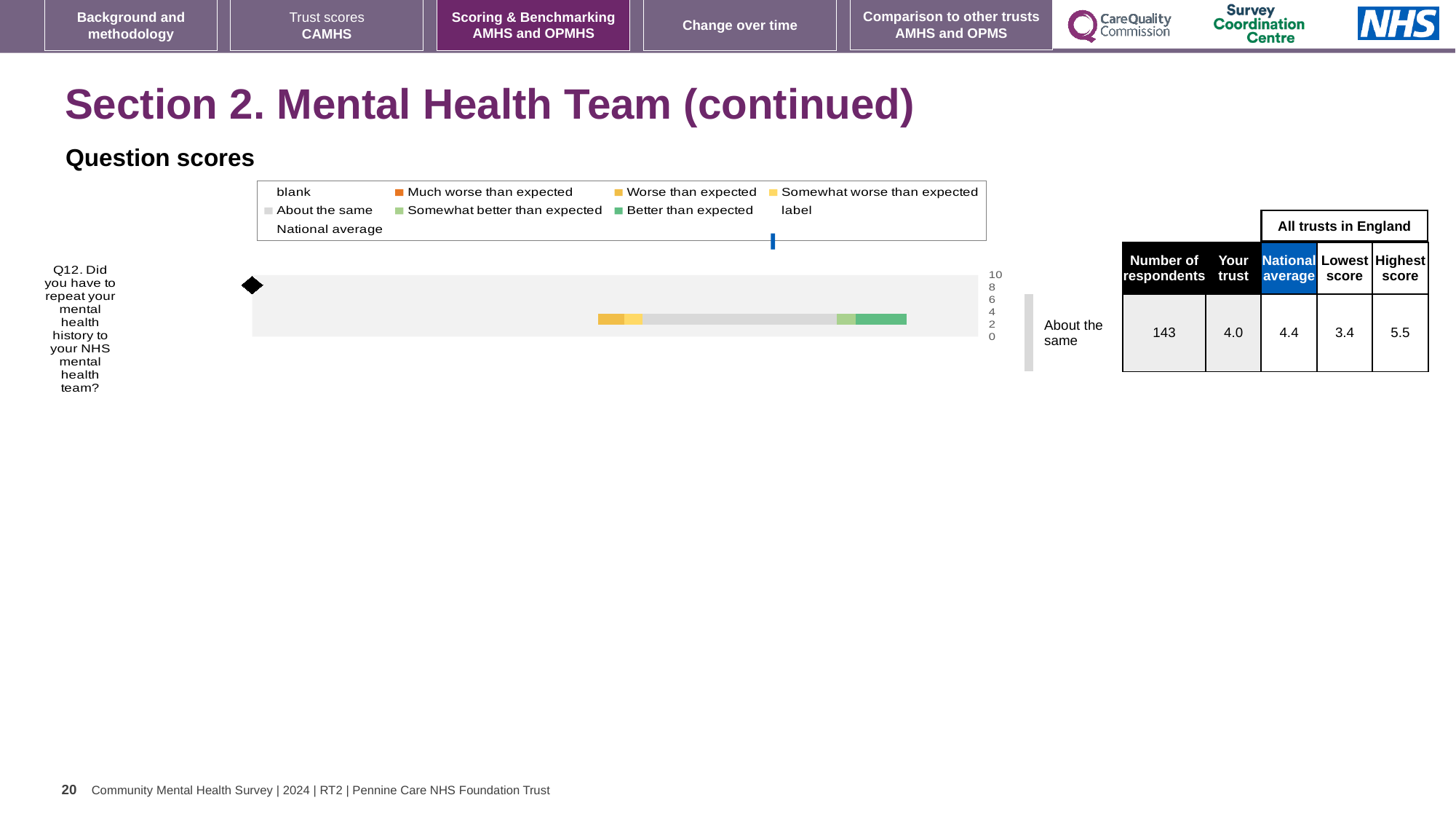
In the table beside the chart, what is the lowest score among all trusts in England for Q12? 3.4 What kind of chart is used to show the question score for Q12? bar chart How many survey questions are plotted on the chart? 1 What is the difference between the national average (4.4) and the 'Your trust' score (4.0) for Q12? 0.4 In the table beside the chart, what is the 'Your trust' score for Q12? 4.0 In the table beside the chart, what is the number of respondents for Q12? 143 What benchmark category is shown next to the chart for Q12? About the same In the table beside the chart, what is the national average score for Q12? 4.4 In the table beside the chart, what is the highest score among all trusts in England for Q12? 5.5 Which is larger for Q12, the 'Your trust' score or the national average? National average Which question is plotted on the chart? Q12. Did you have to repeat your mental health history to your NHS mental health team? Which legend entry is shown in orange? Much worse than expected